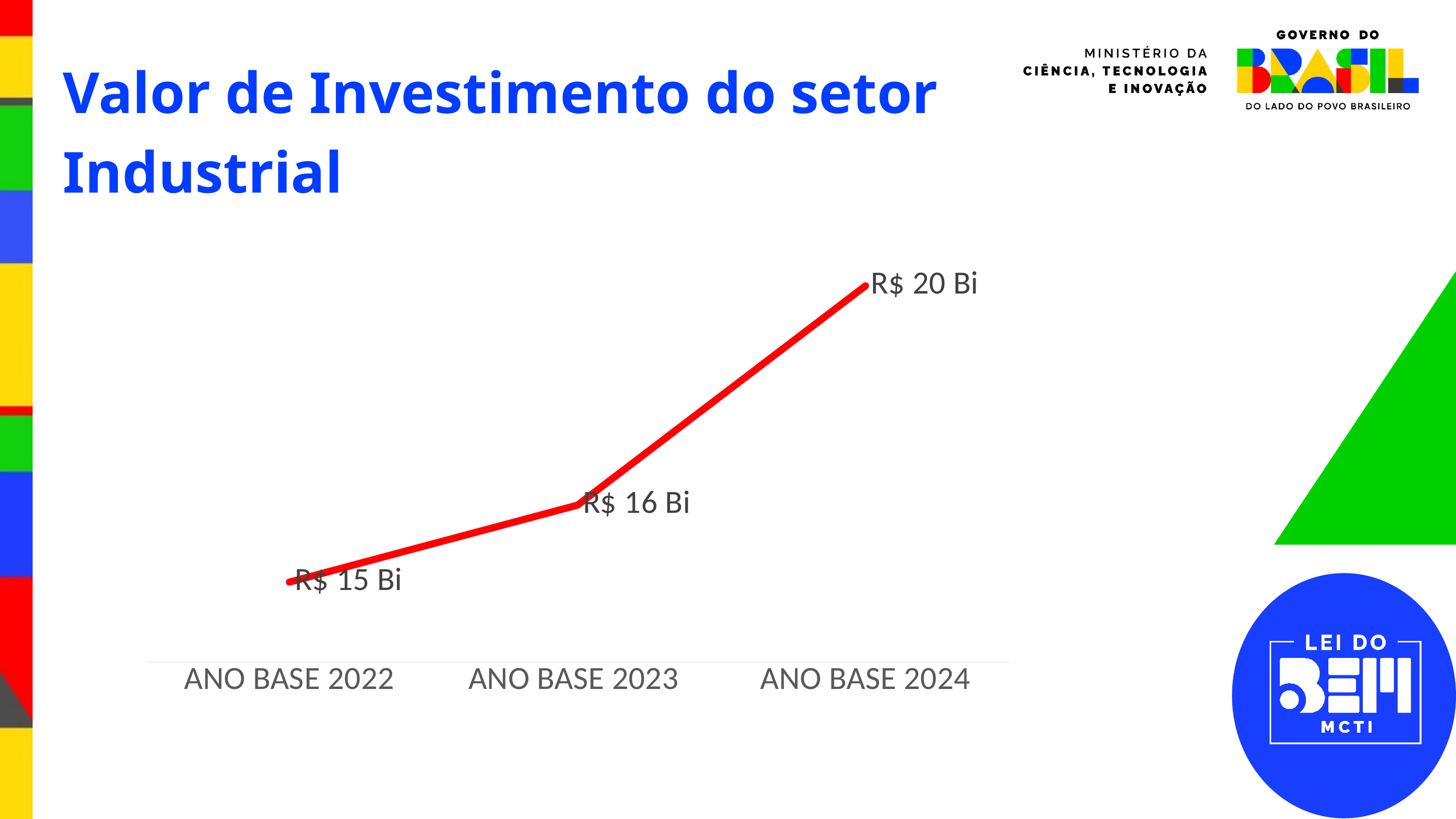
What is the difference between the values for ANO BASE 2024 and ANO BASE 2022? R$ 5 Bi What kind of chart is shown on the slide? Line chart Which is larger, the value for ANO BASE 2023 or ANO BASE 2024? ANO BASE 2024 What is the value for ANO BASE 2022? R$ 15 Bi Which year has the highest investment value? ANO BASE 2024 What is the difference between the values for ANO BASE 2023 and ANO BASE 2022? R$ 1 Bi What is the value for ANO BASE 2024? R$ 20 Bi How many data points are plotted on the chart? 3 Do the values rise or fall from ANO BASE 2022 to ANO BASE 2024? Rise What colour is the line in the chart? Red Which year has the lowest investment value? ANO BASE 2022 What is the value for ANO BASE 2023? R$ 16 Bi